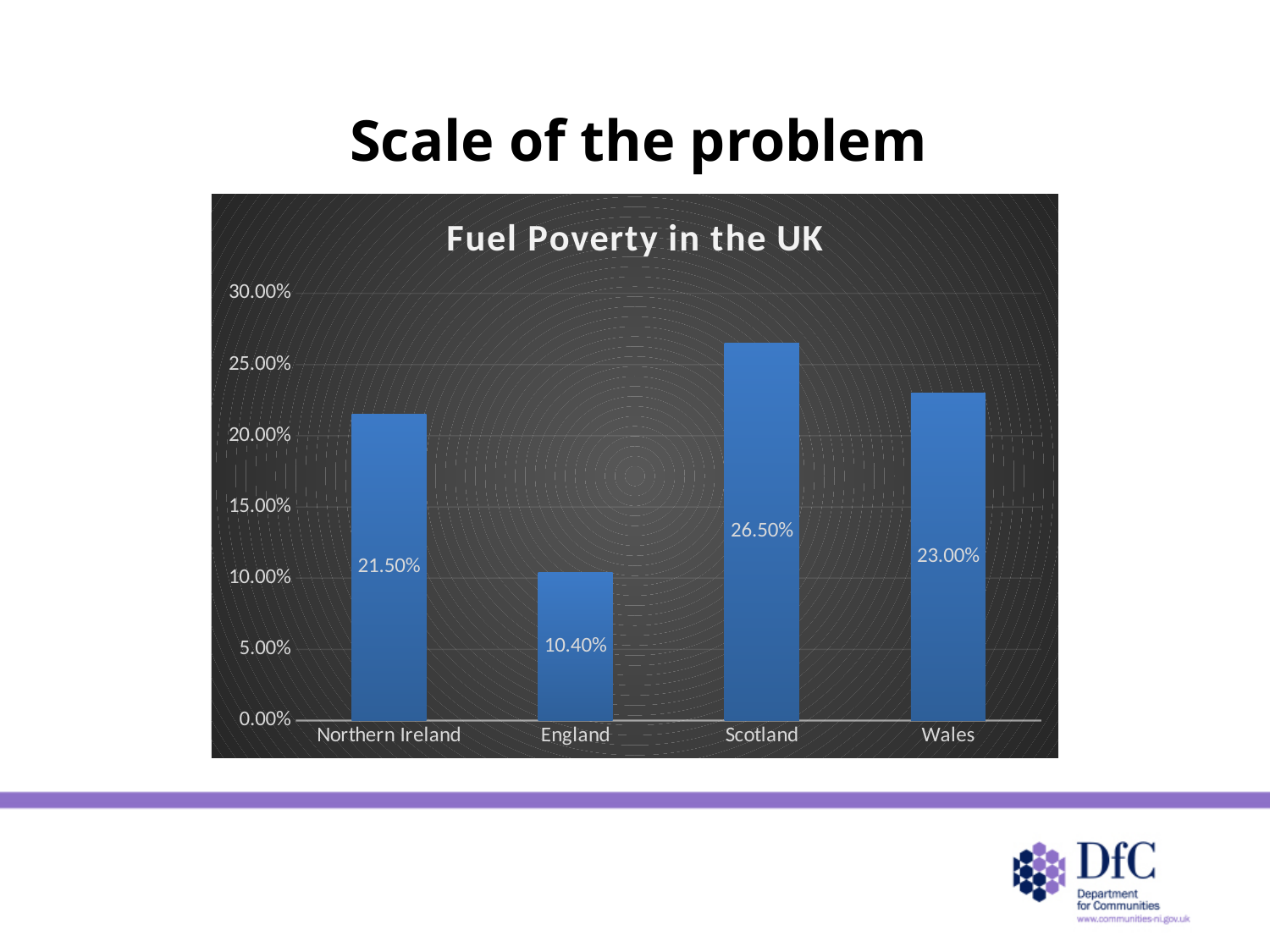
Is the value for Scotland greater or less than 25.00%? greater Which has a higher fuel poverty rate, Wales or Northern Ireland? Wales What is the difference between the fuel poverty rates of Wales and Northern Ireland? 1.50% Which country has the lowest fuel poverty rate? England What is the fuel poverty value for Wales? 23.00% What type of chart is shown on the slide? Bar chart Which country has the highest fuel poverty rate? Scotland What is the fuel poverty value for England? 10.40% What is the fuel poverty value for Scotland? 26.50% What is the difference between the fuel poverty rates of Scotland and England? 16.10% What is the fuel poverty value for Northern Ireland? 21.50% How many countries are shown in the chart? 4